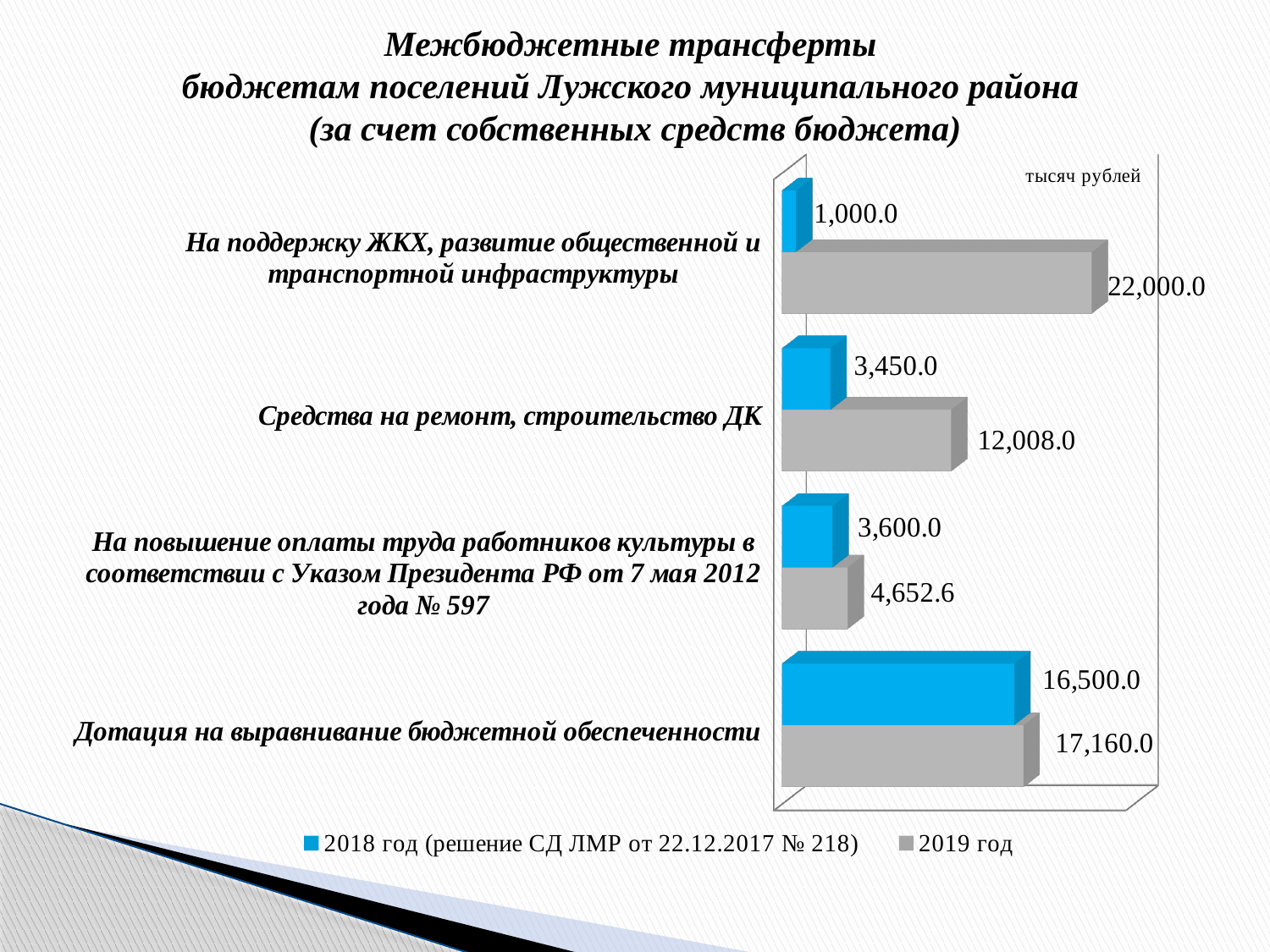
Which category has the highest 2018 год value? Дотация на выравнивание бюджетной обеспеченности How many series does the legend list? 2 What is the 2018 год value for «Дотация на выравнивание бюджетной обеспеченности»? 16,500.0 Which category has the highest 2019 год value? На поддержку ЖКХ, развитие общественной и транспортной инфраструктуры Which category has the lowest 2018 год value? На поддержку ЖКХ, развитие общественной и транспортной инфраструктуры For «Дотация на выравнивание бюджетной обеспеченности», which is larger: the 2018 год value or the 2019 год value? 2019 год What type of chart is shown on the slide? Bar chart How many categories are shown in the chart? 4 What is the difference between the 2019 год and 2018 год values for «Средства на ремонт, строительство ДК»? 8,558.0 What is the 2019 год value for «На повышение оплаты труда работников культуры в соответствии с Указом Президента РФ от 7 мая 2012 года № 597»? 4,652.6 What is the 2019 год value for «На поддержку ЖКХ, развитие общественной и транспортной инфраструктуры»? 22,000.0 What is the 2018 год value for «Средства на ремонт, строительство ДК»? 3,450.0